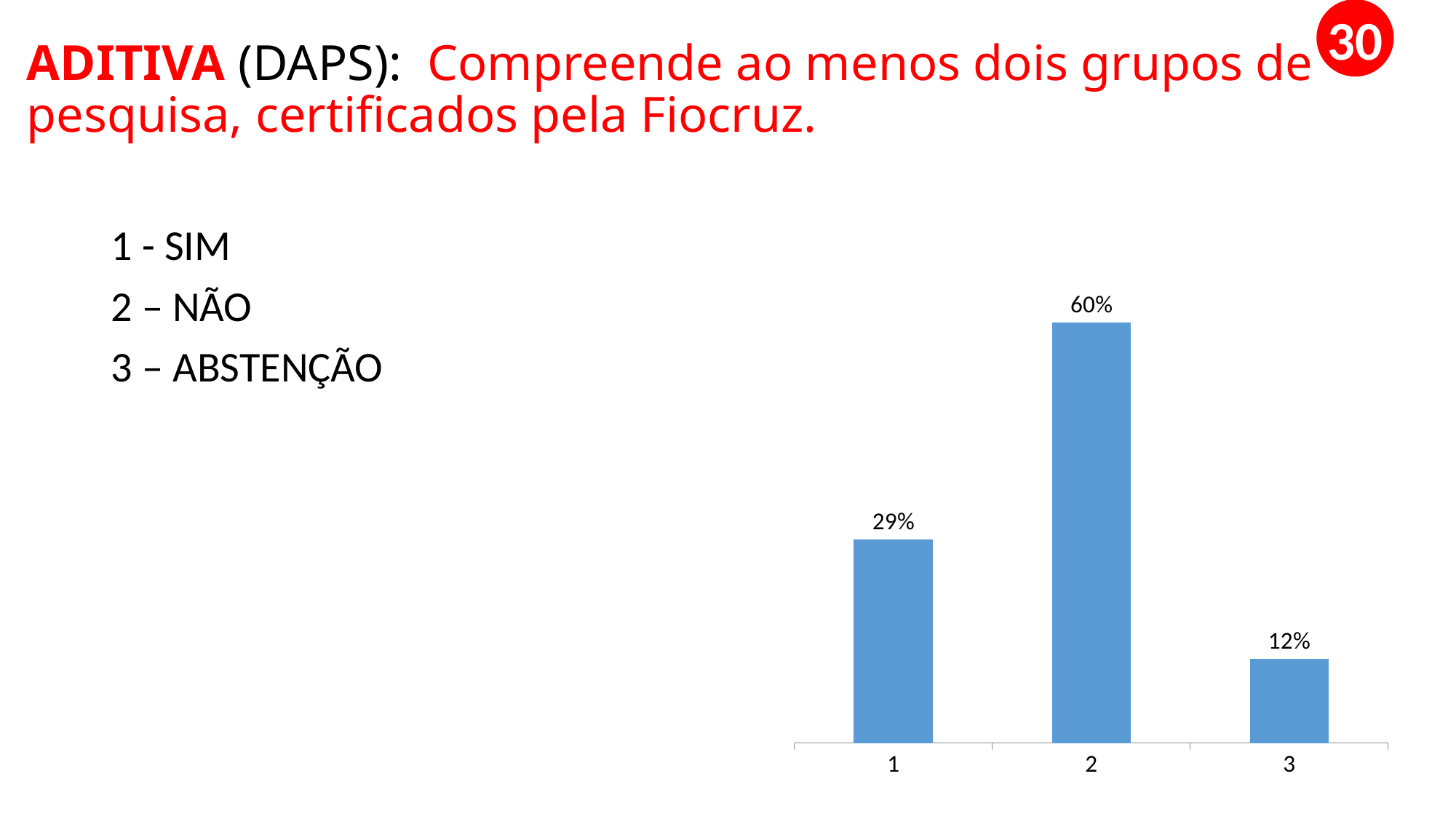
What is the difference between the values for category 1 and category 3? 17% What kind of chart is shown on the slide? bar chart According to the slide's key, what does category 2 stand for? NÃO What is the value for category 2? 60% Which category has the lowest value? 3 What is the value for category 3? 12% What colour are the bars in the chart? blue Which is larger, the value for category 1 or category 3? 1 What is the difference between the values for category 2 and category 1? 31% What is the value for category 1? 29% How many categories are shown on the x axis? 3 Which category has the highest value? 2